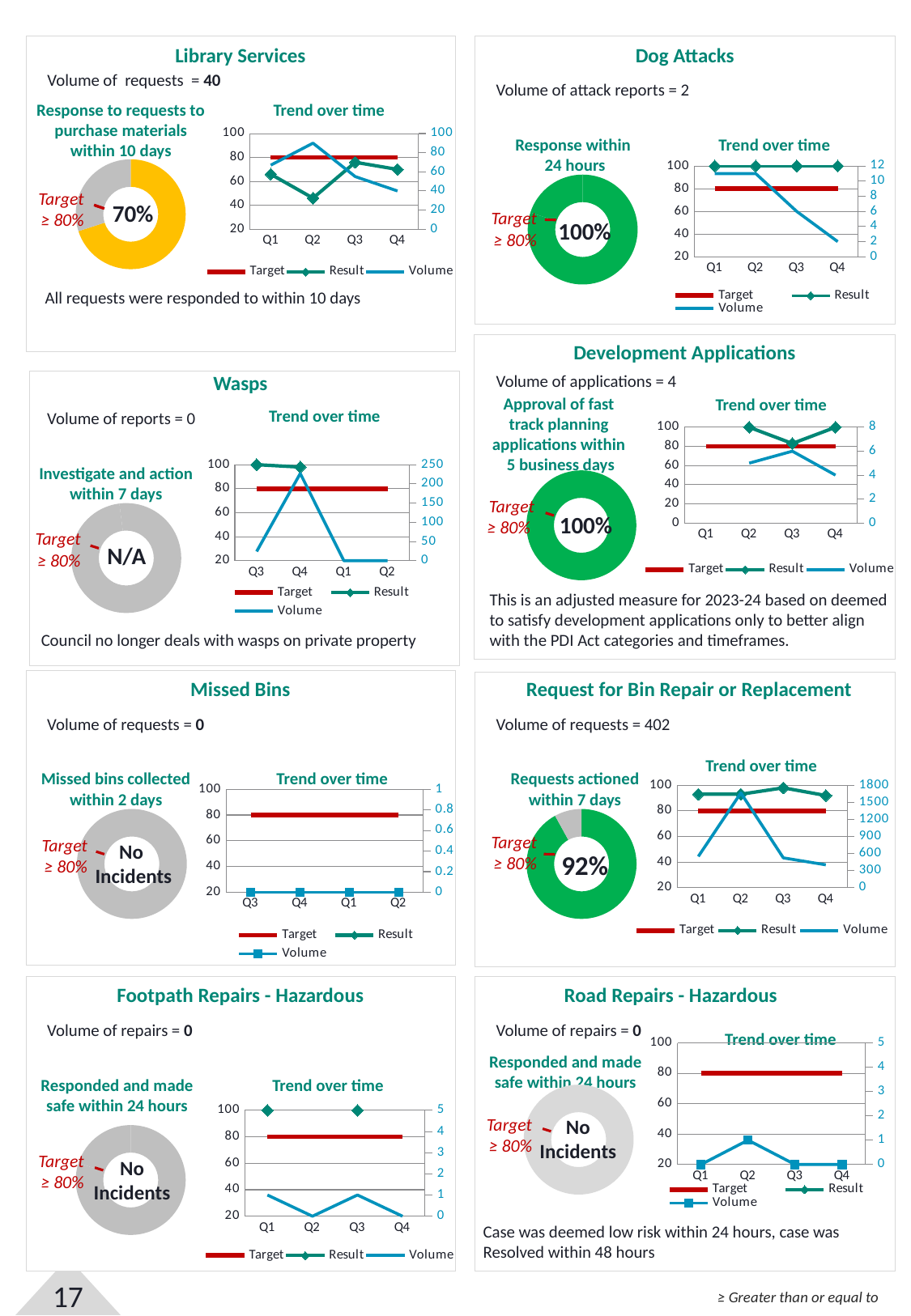
On the Library Services donut chart, what percentage is shown? 70% On the Dog Attacks 'Trend over time' chart, does the Volume line rise or fall from Q2 to Q4? fall On the Library Services 'Trend over time' chart, how many quarters are shown on the x axis? 4 On the Wasps donut chart, what value is shown in the centre? N/A What kind of chart is the Library Services 'Trend over time' chart? line chart On the Library Services 'Trend over time' chart, how many series does the legend list? 3 On the Request for Bin Repair or Replacement donut chart, what percentage of requests were actioned within 7 days? 92% On the Dog Attacks 'Trend over time' chart, is the Volume value for Q4 greater or less than 6? less On the Dog Attacks donut chart, what percentage is shown for response within 24 hours? 100% On the Library Services 'Trend over time' chart, is the Result value for Q2 greater or less than 60? less On the Request for Bin Repair or Replacement 'Trend over time' chart, is the Volume value for Q2 greater or less than 1200? greater